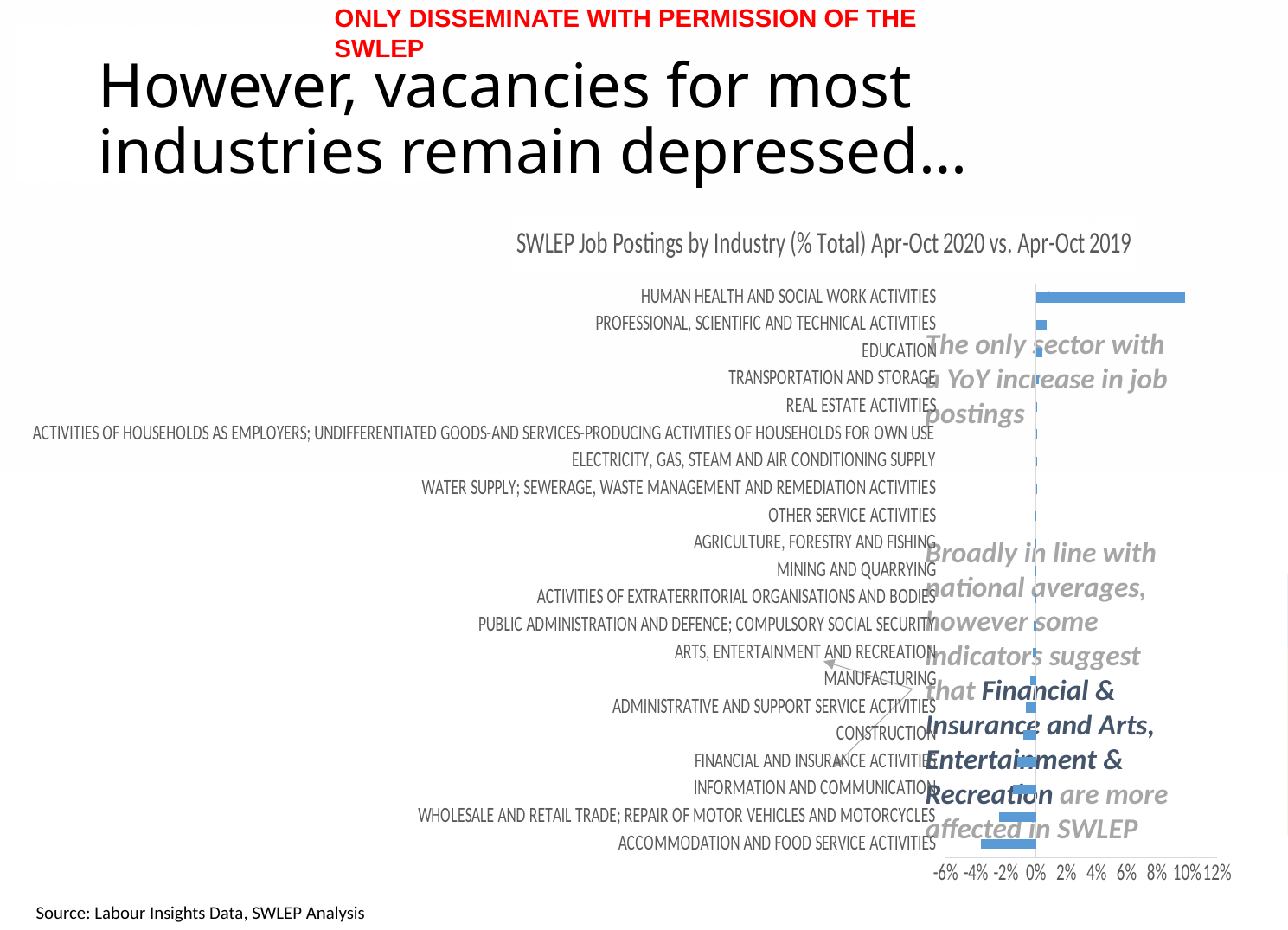
Which is larger, the value for Human Health and Social Work Activities or the value for Professional, Scientific and Technical Activities? Human Health and Social Work Activities Is the value for Accommodation and Food Service Activities greater or less than 0%? less What is the title of the chart? SWLEP Job Postings by Industry (% Total) Apr-Oct 2020 vs. Apr-Oct 2019 How many industry categories are plotted in the chart? 21 Is the value for Human Health and Social Work Activities greater or less than 8%? greater Is the value for Wholesale and Retail Trade; Repair of Motor Vehicles and Motorcycles greater or less than 0%? less Which is larger, the value for Education or the value for Accommodation and Food Service Activities? Education What is the lowest value shown on the chart's horizontal axis? -6% What kind of chart is shown on the slide? Bar chart Which industry has the highest value in the chart? Human Health and Social Work Activities